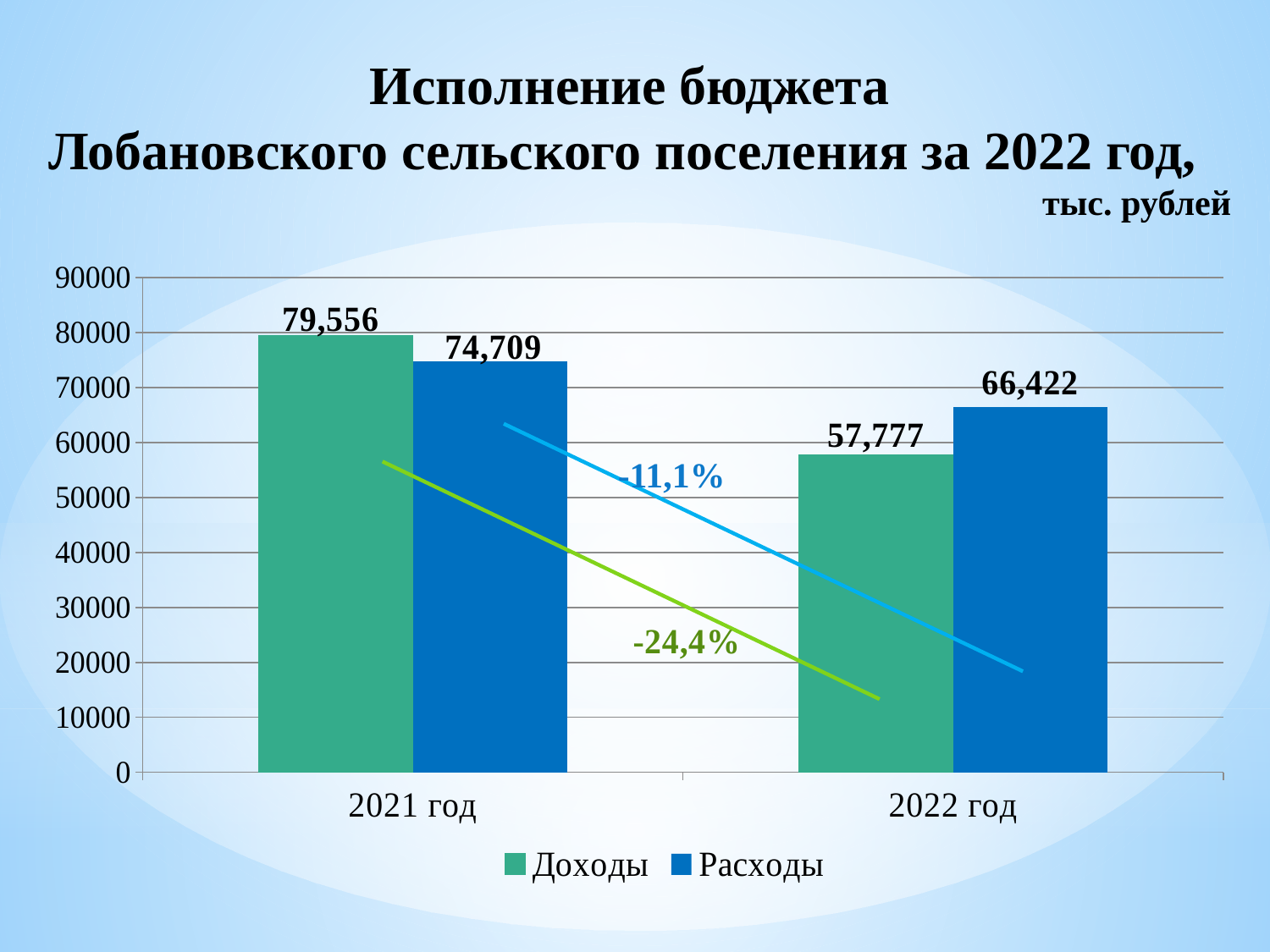
What is the value of Доходы for 2022 год? 57,777 What is the value of Расходы for 2021 год? 74,709 What is the value of Доходы for 2021 год? 79,556 What is the difference between Доходы and Расходы in 2021 год? 4,847 Which bar has the highest value on the chart? Доходы, 2021 год In 2022 год, which is larger: Доходы or Расходы? Расходы Which bar has the lowest value on the chart? Доходы, 2022 год What is the value of Расходы for 2022 год? 66,422 What kind of chart is shown on the slide? Bar chart Do the Доходы values rise or fall from 2021 год to 2022 год? Fall How many series does the legend list? 2 What is the difference between Расходы and Доходы in 2022 год? 8,645